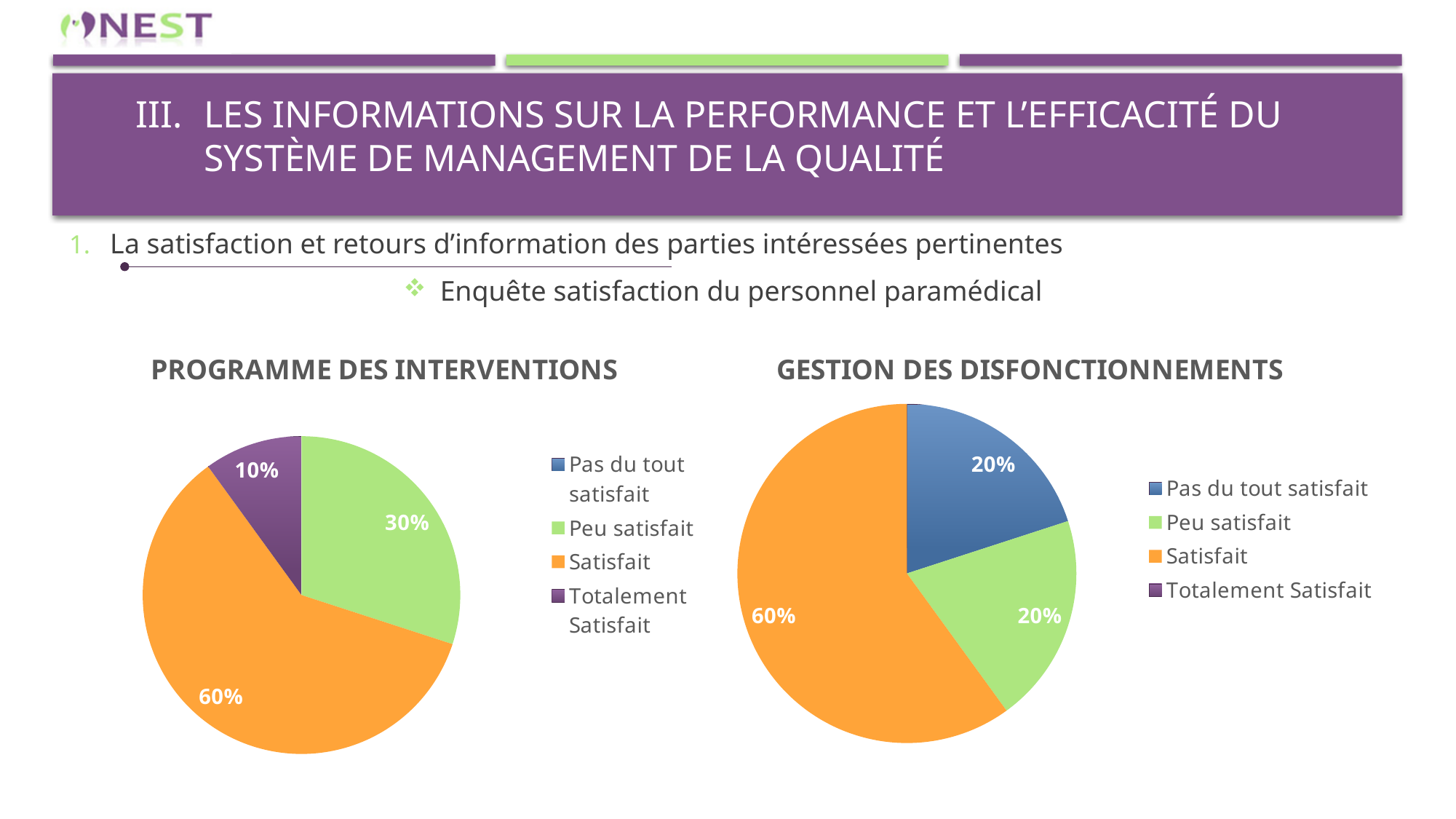
In the 'GESTION DES DISFONCTIONNEMENTS' chart, what share is labelled for 'Pas du tout satisfait'? 20% In the 'PROGRAMME DES INTERVENTIONS' chart, which labelled category has the smallest slice? Totalement Satisfait In the 'PROGRAMME DES INTERVENTIONS' chart, what share is labelled for 'Totalement Satisfait'? 10% In the 'PROGRAMME DES INTERVENTIONS' chart, what share is labelled for 'Satisfait'? 60% In the 'PROGRAMME DES INTERVENTIONS' chart, what is the difference between the 'Satisfait' and 'Peu satisfait' shares? 30% In the 'GESTION DES DISFONCTIONNEMENTS' chart, what share is labelled for 'Satisfait'? 60% In the 'PROGRAMME DES INTERVENTIONS' chart, what share is labelled for 'Peu satisfait'? 30% In the 'PROGRAMME DES INTERVENTIONS' chart, which category has the largest slice? Satisfait In the 'GESTION DES DISFONCTIONNEMENTS' chart, which category has the largest slice? Satisfait What kind of chart is 'GESTION DES DISFONCTIONNEMENTS'? pie chart In the 'GESTION DES DISFONCTIONNEMENTS' chart, is the 'Satisfait' share larger or smaller than the 'Peu satisfait' share? larger How many entries does the legend of the 'PROGRAMME DES INTERVENTIONS' chart list? 4